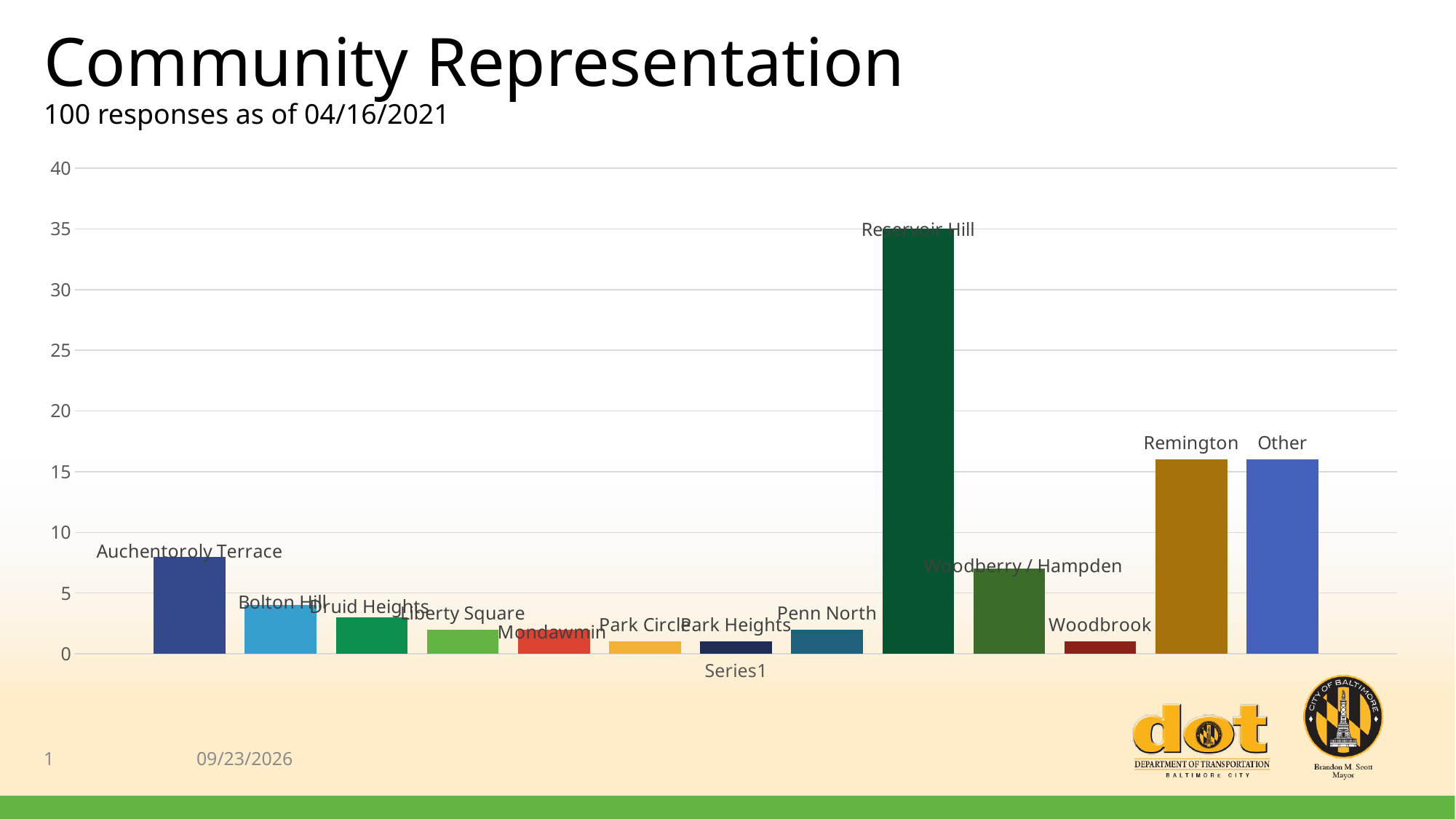
Is the value for Auchentoroly Terrace greater or less than 10? less Which community has the highest bar in the chart? Reservoir Hill Is the value for Reservoir Hill greater or less than 30? greater What is the title of the slide containing the chart? Community Representation According to the subtitle, how many responses does the chart represent and as of what date? 100 responses as of 04/16/2021 How many community bars are plotted in the chart? 13 Is the value for Woodberry / Hampden greater or less than 5? greater What kind of chart is shown on the slide? bar chart Which is larger, the value for Reservoir Hill or the value for Remington? Reservoir Hill Which is larger, the value for Auchentoroly Terrace or the value for Bolton Hill? Auchentoroly Terrace